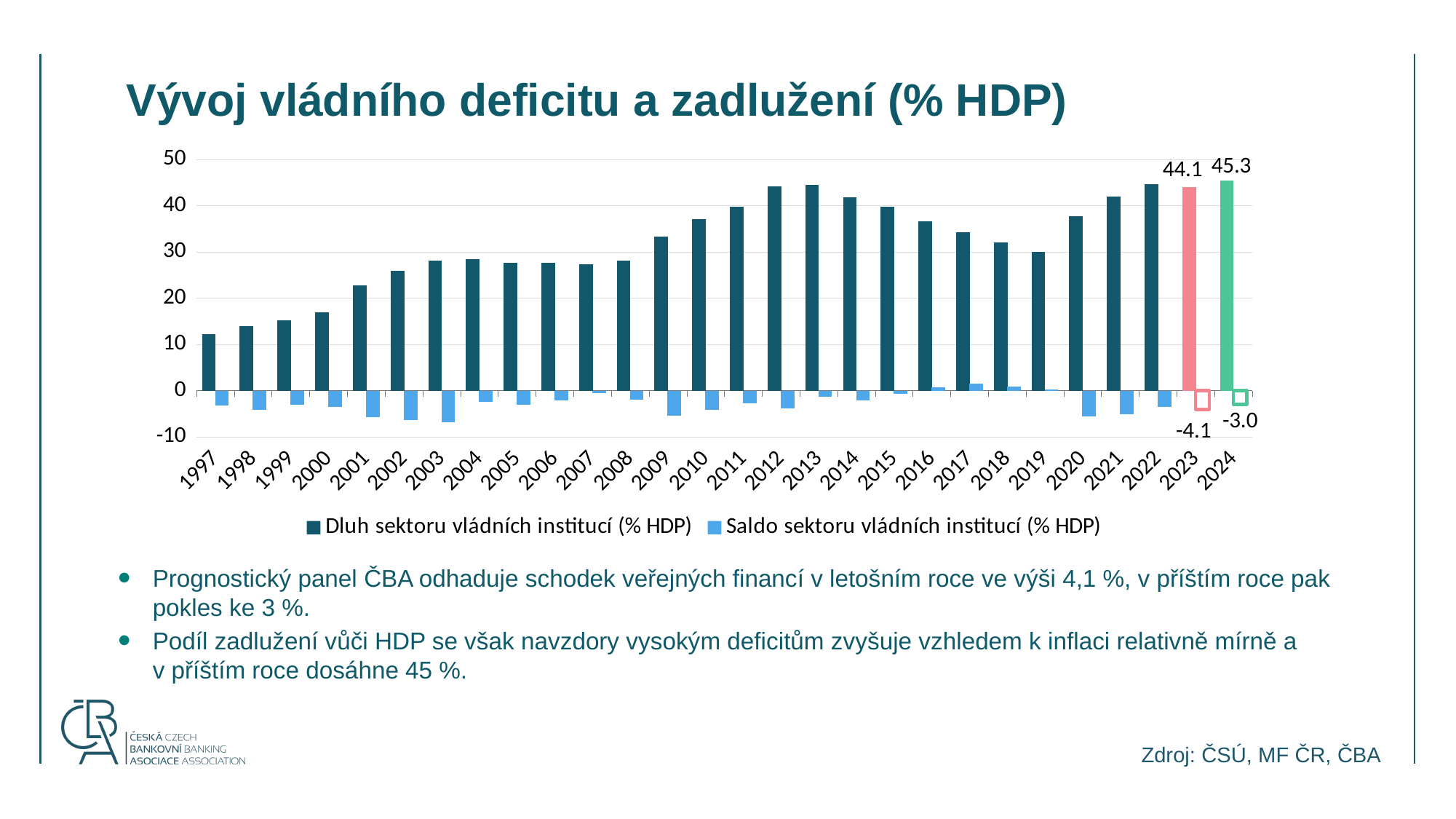
How many series does the legend list? 2 Is the value of Dluh sektoru vládních institucí for 1997 greater or less than 20? less Which year has the lowest value of Dluh sektoru vládních institucí (% HDP)? 1997 How many years are shown on the x axis of the chart? 28 Is the value of Dluh sektoru vládních institucí for 2013 greater or less than 40? greater What is the value of Saldo sektoru vládních institucí (% HDP) for 2024? -3.0 Is the value of Dluh sektoru vládních institucí for 2019 greater or less than 40? less What is the value of Dluh sektoru vládních institucí (% HDP) for 2024? 45.3 What is the value of Dluh sektoru vládních institucí (% HDP) for 2023? 44.1 What kind of chart is shown on the slide? bar chart What is the value of Saldo sektoru vládních institucí (% HDP) for 2023? -4.1 By how much does the debt (Dluh sektoru vládních institucí) for 2024 exceed that for 2023? 1.2